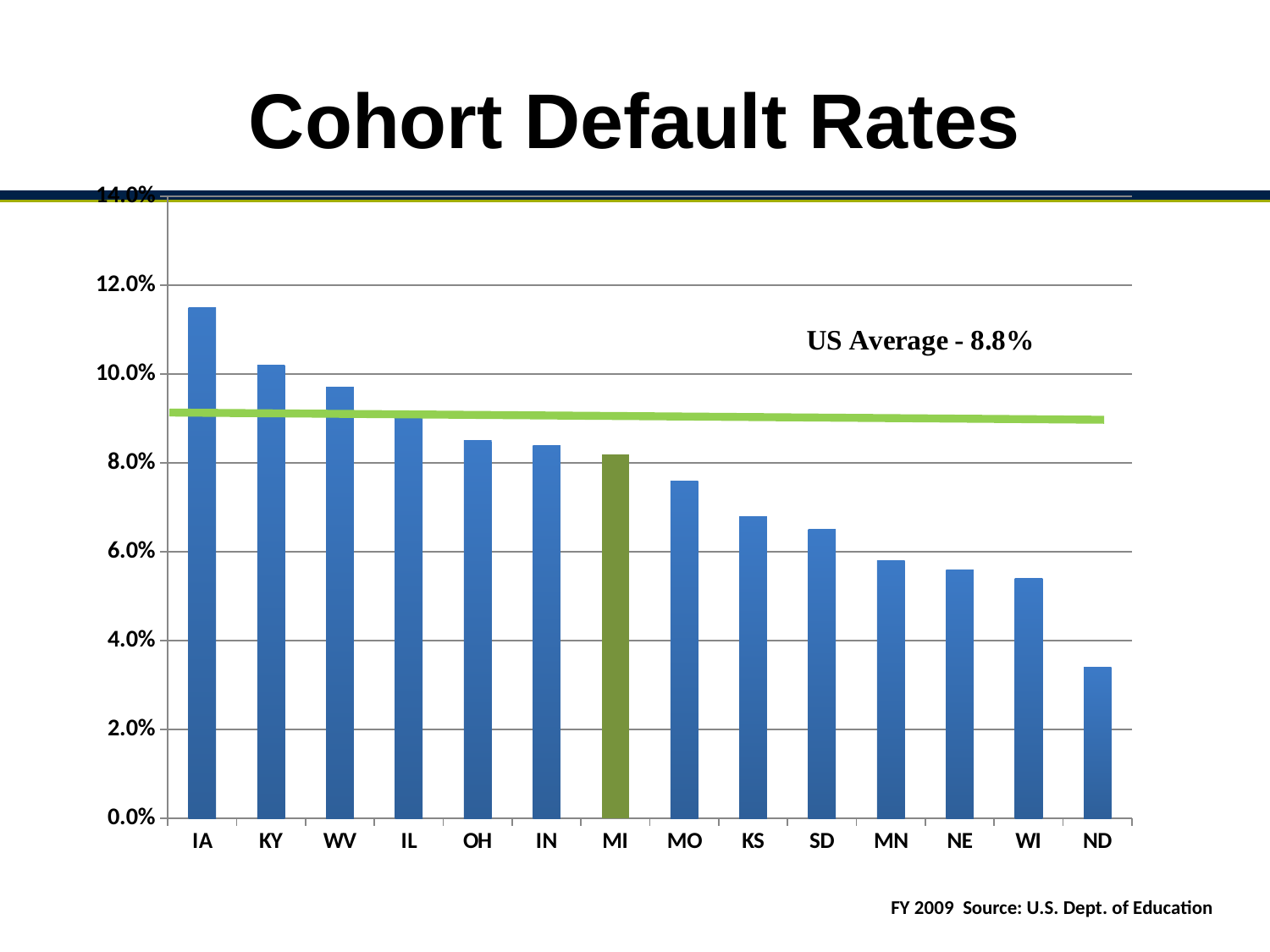
Which state has the lowest cohort default rate? ND Do the bar values rise or fall from left to right along the x axis? fall Which state has the highest cohort default rate? IA Is the value for KY greater or less than 10.0%? greater What kind of chart is shown on the slide? bar chart How many states are shown on the x axis? 14 Is the value for MO greater or less than 8.0%? less Is the value for ND greater or less than 4.0%? less What US average value is stated on the chart? 8.8% Which state's bar is coloured green instead of blue? MI Which has a higher cohort default rate, KY or MO? KY